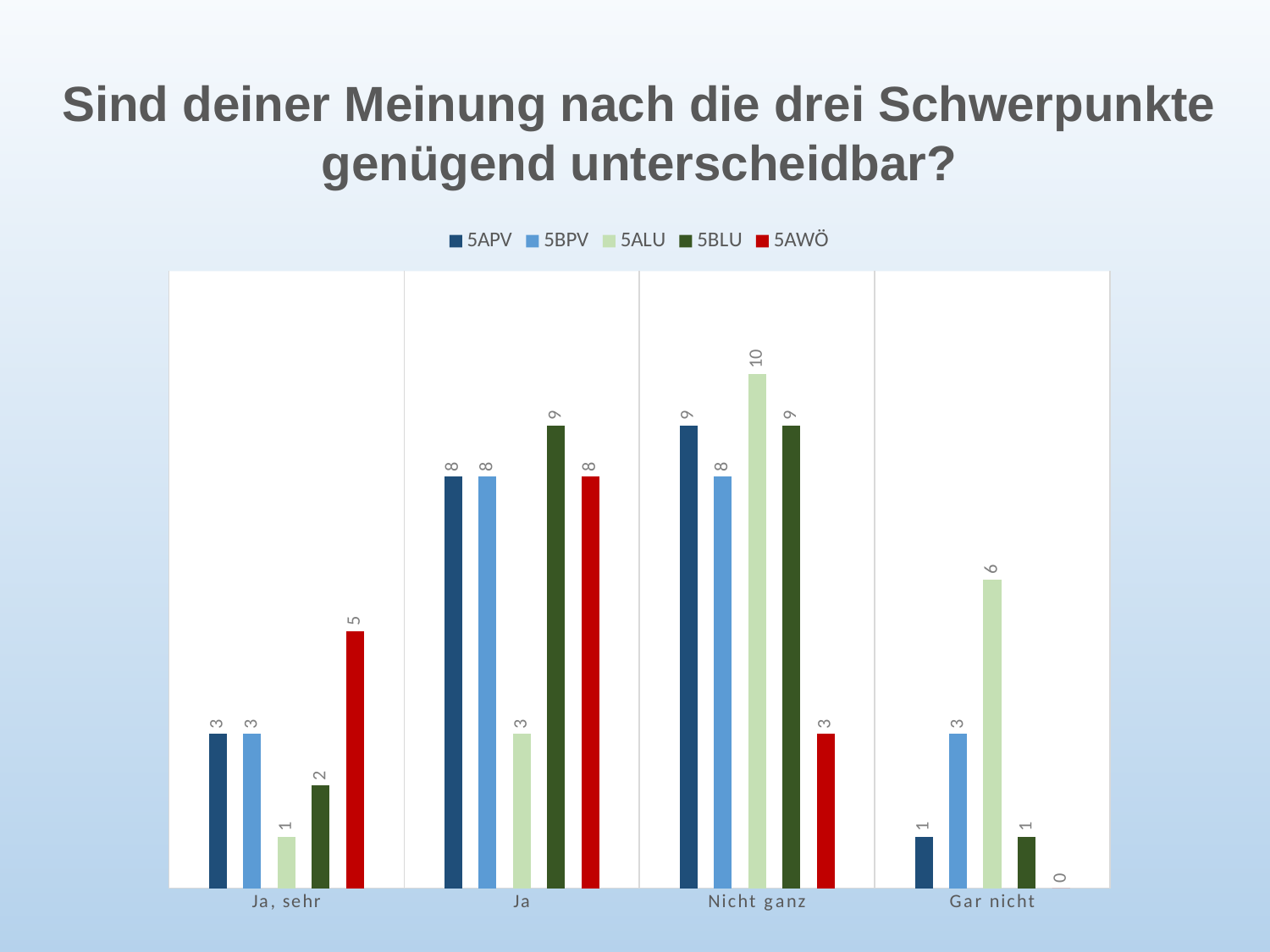
How many series does the legend list? 5 Which series has the highest value in the "Gar nicht" category? 5ALU Which series has the lowest value in the "Ja, sehr" category? 5ALU How many categories are shown on the x axis? 4 What is the value for 5AWÖ in the "Ja, sehr" category? 5 What is the value for 5AWÖ in the "Gar nicht" category? 0 What is the value for 5BLU in the "Ja" category? 9 Which is larger: the 5ALU value for "Ja" or the 5ALU value for "Gar nicht"? 5ALU value for "Gar nicht" What is the difference between the 5ALU value and the 5AWÖ value in the "Nicht ganz" category? 7 What kind of chart is shown on the slide? Bar chart What is the value for 5ALU in the "Nicht ganz" category? 10 Which series is shown in red in the legend? 5AWÖ